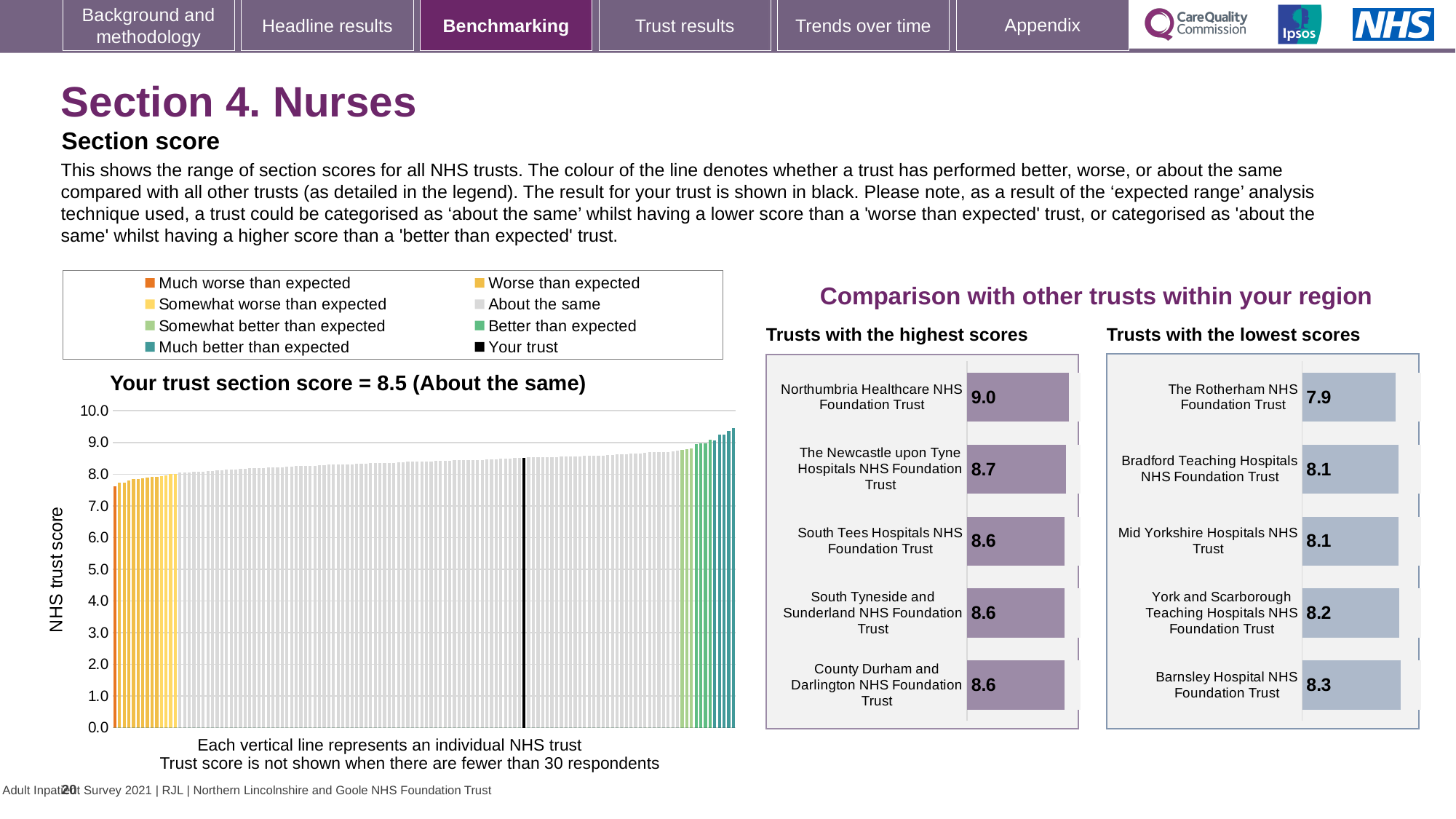
In the 'Your trust section score' chart, do the trust scores rise or fall from left to right? rise In the 'Your trust section score' chart, what is the section score for your trust? 8.5 In the 'Trusts with the highest scores' chart, what is the difference between the scores of Northumbria Healthcare NHS Foundation Trust and The Newcastle upon Tyne Hospitals NHS Foundation Trust? 0.3 How many trusts are shown in the 'Trusts with the highest scores' chart? 5 In the 'Your trust section score' chart, which category does your trust fall into according to the chart title? About the same In the 'Trusts with the highest scores' chart, which trust has the highest score? Northumbria Healthcare NHS Foundation Trust In the 'Trusts with the highest scores' chart, what is the score for Northumbria Healthcare NHS Foundation Trust? 9.0 In the 'Trusts with the lowest scores' chart, which trust has the lowest score? The Rotherham NHS Foundation Trust In the 'Trusts with the lowest scores' chart, which has the larger score: Barnsley Hospital NHS Foundation Trust or The Rotherham NHS Foundation Trust? Barnsley Hospital NHS Foundation Trust How many entries does the legend above the 'Your trust section score' chart list? 8 In the 'Trusts with the lowest scores' chart, what is the score for The Rotherham NHS Foundation Trust? 7.9 What kind of chart is the 'Your trust section score' chart? bar chart